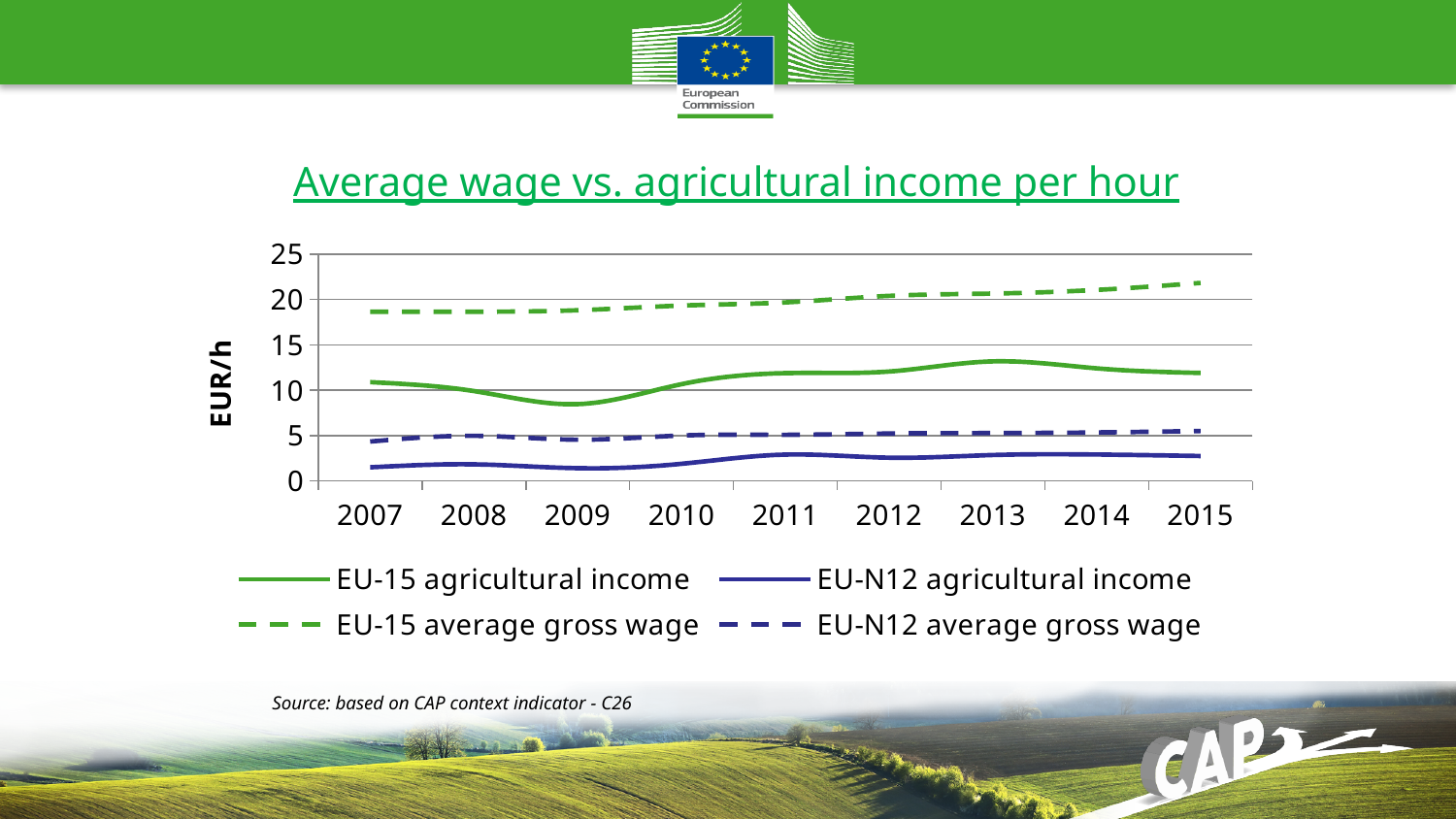
Which series has the highest values across all years? EU-15 average gross wage Does the EU-15 average gross wage rise or fall from 2007 to 2015? Rises In 2015, which is larger: EU-15 agricultural income or EU-N12 average gross wage? EU-15 agricultural income What is the label on the y axis? EUR/h What kind of chart is shown on the slide? Line chart In which year is EU-15 agricultural income at its lowest? 2009 Is the value for EU-N12 agricultural income in 2007 greater or less than 5? less How many years are shown on the x axis? 9 How many series does the legend list? 4 Is the value for EU-15 agricultural income in 2013 greater or less than 10? greater Is the value for EU-15 average gross wage in 2015 greater or less than 20? greater